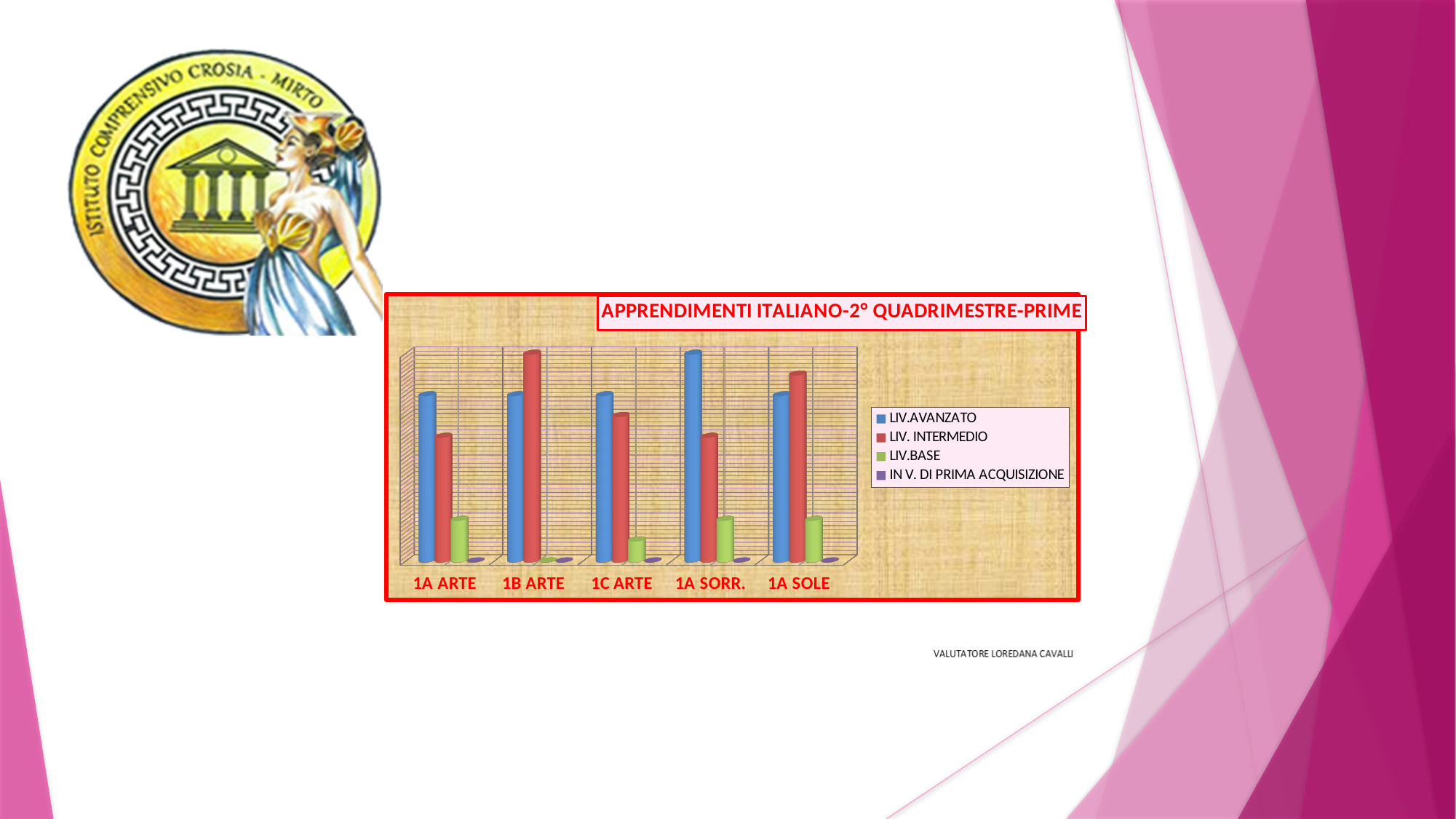
Which class has the highest LIV.AVANZATO bar? 1A SORR. For 1B ARTE, which is larger: LIV.AVANZATO or LIV. INTERMEDIO? LIV. INTERMEDIO How many classes (categories) are shown on the x axis of the chart? 5 What kind of chart is shown on the slide? bar chart For 1A SORR., which series has the lowest bar? IN V. DI PRIMA ACQUISIZIONE For 1A ARTE, which is larger: LIV.AVANZATO or LIV. INTERMEDIO? LIV.AVANZATO What colour represents LIV.BASE in the chart? green How many series does the chart legend list? 4 What is the title of the chart? APPRENDIMENTI ITALIANO-2° QUADRIMESTRE-PRIME Which class has the lowest LIV.BASE bar? 1B ARTE For 1A SOLE, which is larger: LIV.AVANZATO or LIV. INTERMEDIO? LIV. INTERMEDIO Which class has the highest LIV. INTERMEDIO bar? 1B ARTE